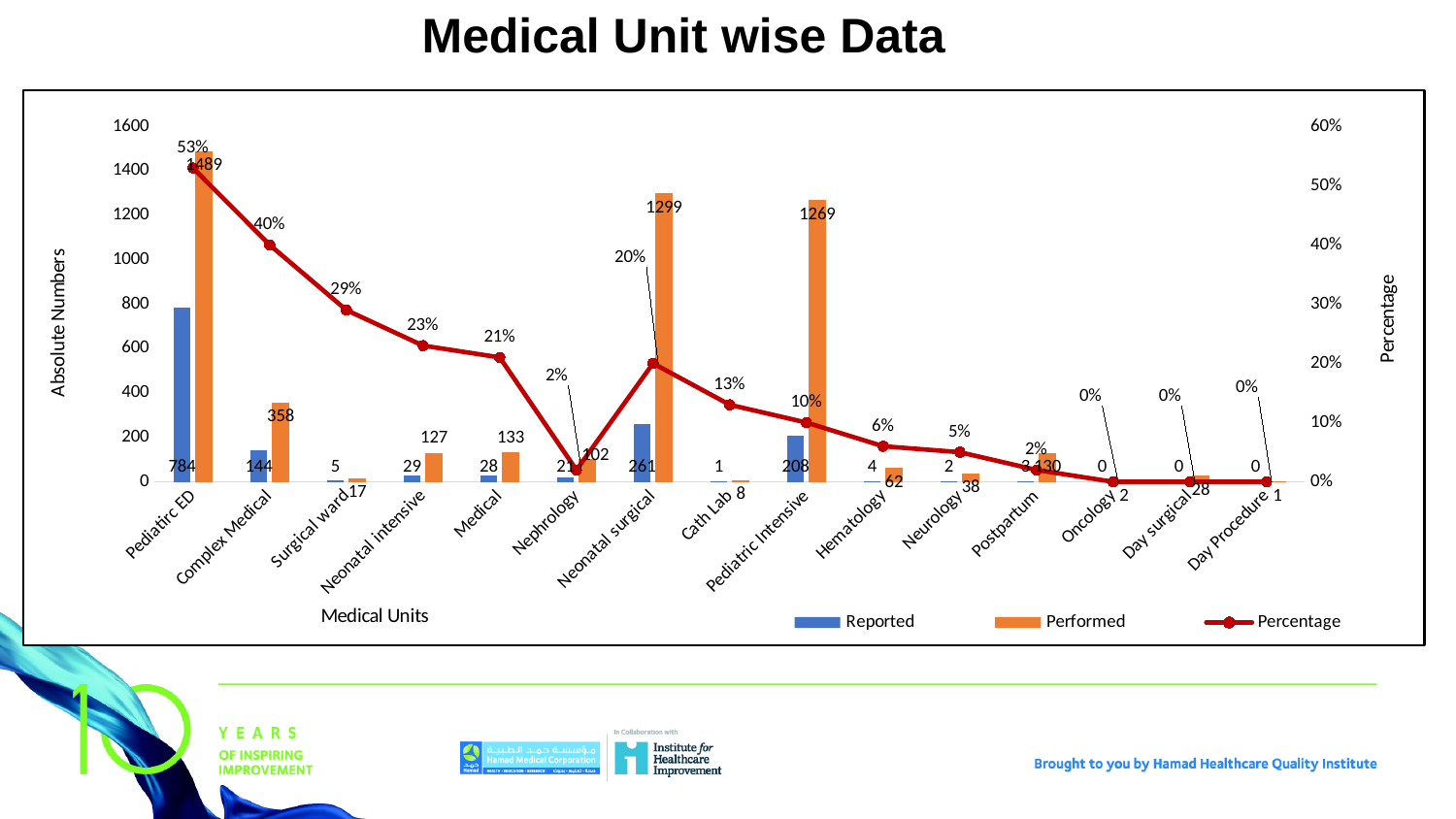
What is the difference between the Performed values for Pediatirc ED and Neonatal surgical? 190 What kind of chart is shown on the slide? Combination bar and line chart What is the Percentage value for Complex Medical? 40% Which medical unit has the highest Performed value? Pediatirc ED What is the Reported value for Neonatal surgical? 261 Which medical unit has the highest Percentage value? Pediatirc ED Does the Percentage line rise or fall from Pediatirc ED to Medical? Fall What is the Performed value for Pediatirc ED? 1489 Which has a larger Reported value, Complex Medical or Pediatric Intensive? Pediatric Intensive How many medical units are shown on the x axis? 15 What is the Performed value for Hematology? 62 How many series does the legend list? 3